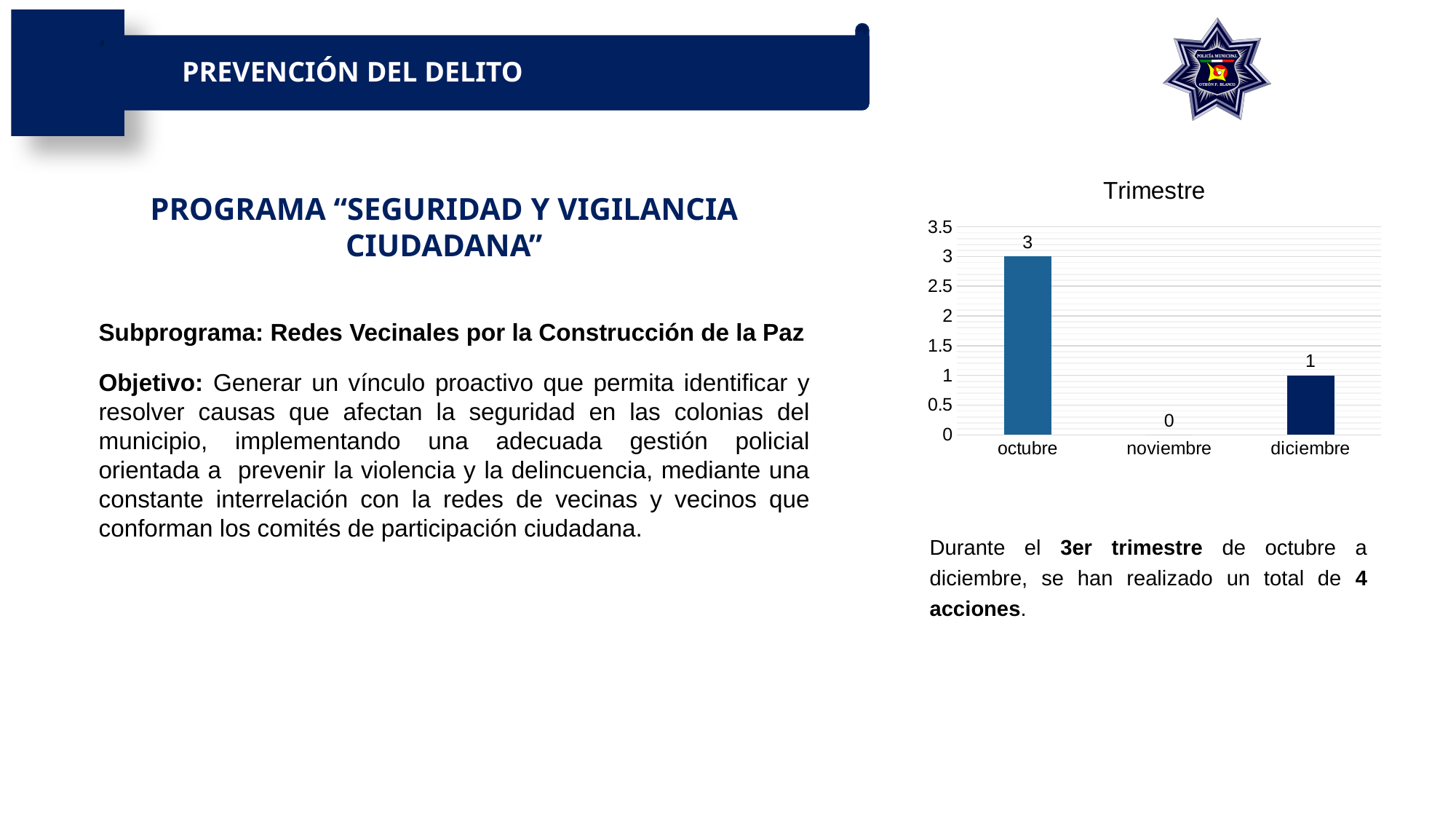
What is the value for noviembre in the Trimestre chart? 0 What is the difference between the values for octubre and diciembre in the Trimestre chart? 2 What is the highest value shown on the y axis of the Trimestre chart? 3.5 Which month has the lowest value in the Trimestre chart? noviembre Which is larger in the Trimestre chart, the value for octubre or the value for diciembre? octubre What kind of chart is the Trimestre chart? bar chart Which month has the highest value in the Trimestre chart? octubre What is the value for diciembre in the Trimestre chart? 1 How many months are shown on the x axis of the Trimestre chart? 3 Is the value for octubre in the Trimestre chart greater or less than 2? greater What is the value for octubre in the Trimestre chart? 3 What is the title of the chart on the slide? Trimestre